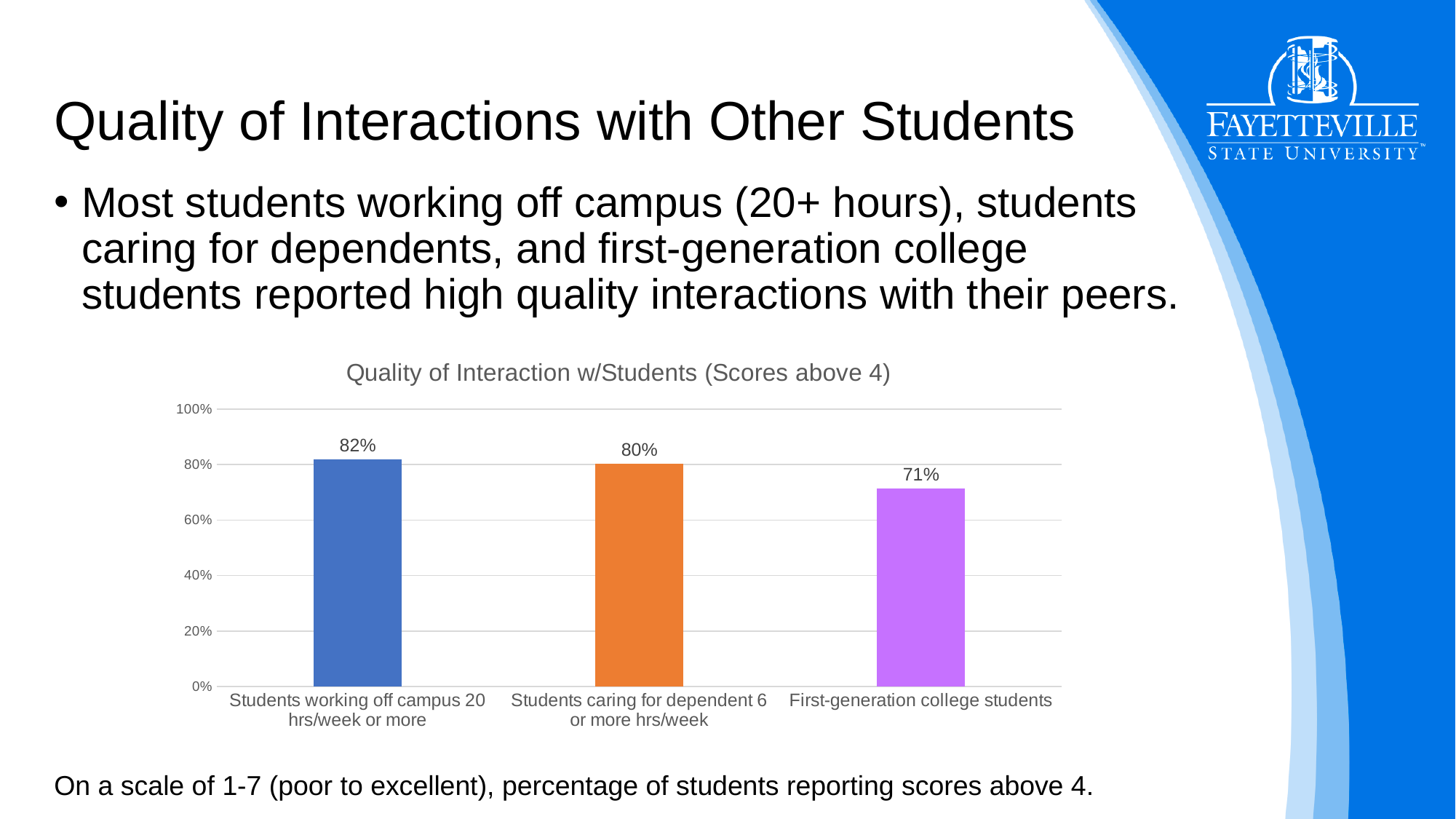
What is the difference between the values for Students working off campus 20 hrs/week or more and First-generation college students? 11% Is the value for First-generation college students greater or less than 80%? less Which category has the lowest value? First-generation college students How many categories are shown in the chart? 3 What is the value for First-generation college students? 71% What is the title of the chart? Quality of Interaction w/Students (Scores above 4) Which category has the highest value? Students working off campus 20 hrs/week or more What is the difference between the values for Students caring for dependent 6 or more hrs/week and First-generation college students? 9% What is the value for Students caring for dependent 6 or more hrs/week? 80% What kind of chart is shown on the slide? bar chart What is the value for Students working off campus 20 hrs/week or more? 82% Which is larger, the value for Students caring for dependent 6 or more hrs/week or the value for First-generation college students? Students caring for dependent 6 or more hrs/week